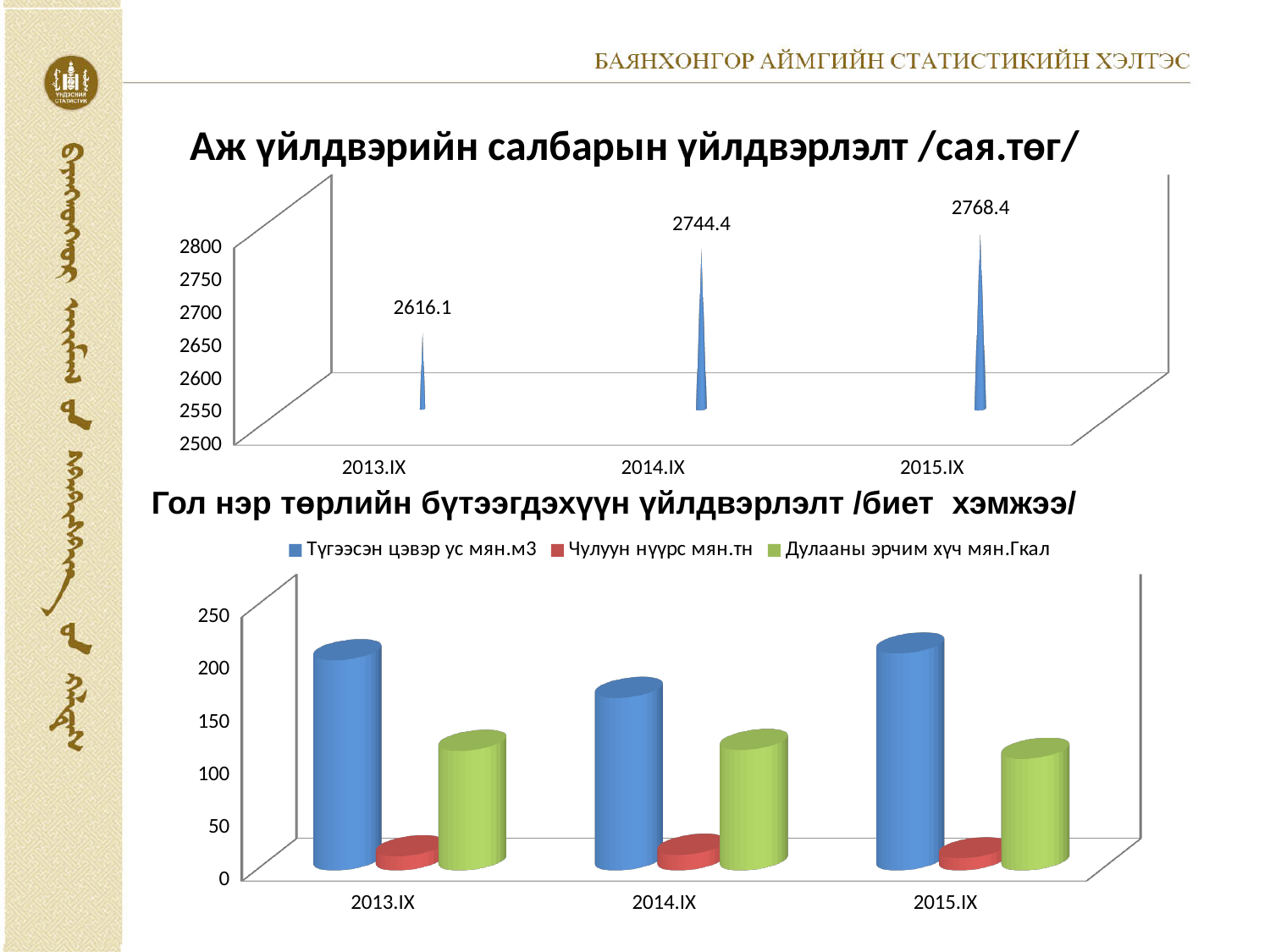
In the top chart (Аж үйлдвэрийн салбарын үйлдвэрлэлт), what is the value for 2015.IX? 2768.4 What type of chart is the bottom chart (Гол нэр төрлийн бүтээгдэхүүн үйлдвэрлэлт)? bar chart In the top chart (Аж үйлдвэрийн салбарын үйлдвэрлэлт), how many periods are shown on the x axis? 3 In the bottom chart (Гол нэр төрлийн бүтээгдэхүүн үйлдвэрлэлт), how many series does the legend list? 3 In the top chart (Аж үйлдвэрийн салбарын үйлдвэрлэлт), do the values rise or fall from 2013.IX to 2015.IX? rise In the bottom chart (Гол нэр төрлийн бүтээгдэхүүн үйлдвэрлэлт), is the value for Түгээсэн цэвэр ус мян.м3 in 2013.IX greater or less than 150? greater In the top chart (Аж үйлдвэрийн салбарын үйлдвэрлэлт), what is the value for 2013.IX? 2616.1 In the bottom chart (Гол нэр төрлийн бүтээгдэхүүн үйлдвэрлэлт), is the value for Чулуун нүүрс мян.тн in 2014.IX greater or less than 50? less In the top chart (Аж үйлдвэрийн салбарын үйлдвэрлэлт), what is the difference between the 2014.IX and 2013.IX values? 128.3 In the bottom chart (Гол нэр төрлийн бүтээгдэхүүн үйлдвэрлэлт), in which period is Түгээсэн цэвэр ус мян.м3 lowest? 2014.IX In the bottom chart (Гол нэр төрлийн бүтээгдэхүүн үйлдвэрлэлт), which is larger in 2015.IX: Түгээсэн цэвэр ус мян.м3 or Дулааны эрчим хүч мян.Гкал? Түгээсэн цэвэр ус мян.м3 In the top chart (Аж үйлдвэрийн салбарын үйлдвэрлэлт), which period has the lowest value? 2013.IX